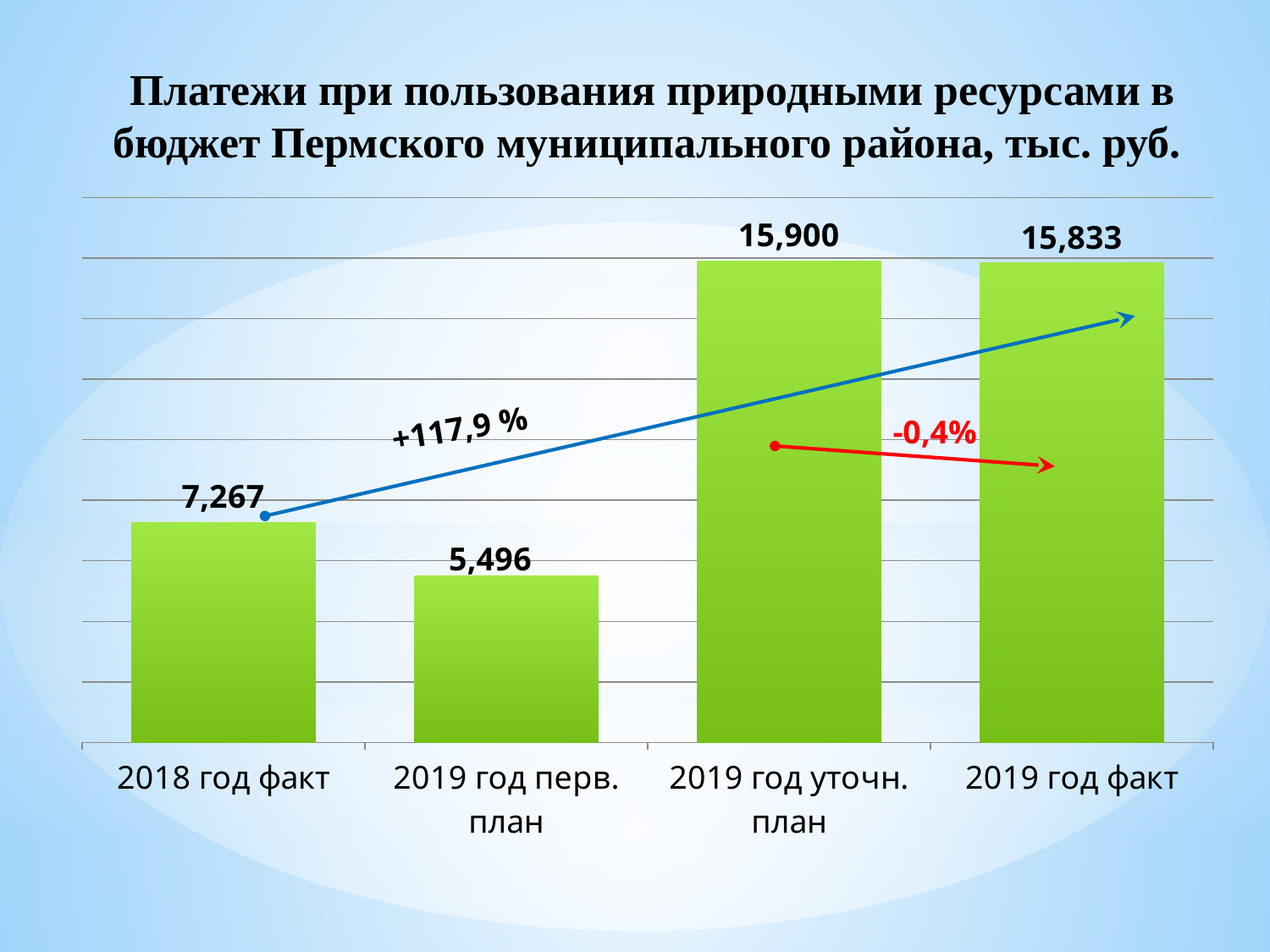
What is the value for 2018 год факт? 7,267 Which category has the lowest value? 2019 год перв. план Which is larger, the value for 2018 год факт or the value for 2019 год перв. план? 2018 год факт What type of chart is shown on the slide? bar chart What is the difference between the values for 2018 год факт and 2019 год перв. план? 1,771 How many categories are shown on the x axis? 4 What is the value for 2019 год уточн. план? 15,900 Which category has the highest value? 2019 год уточн. план What is the value for 2019 год перв. план? 5,496 What is the difference between the values for 2019 год уточн. план and 2019 год факт? 67 What is the value for 2019 год факт? 15,833 What percentage change is shown by the blue arrow between 2018 год факт and 2019 год факт? +117,9 %